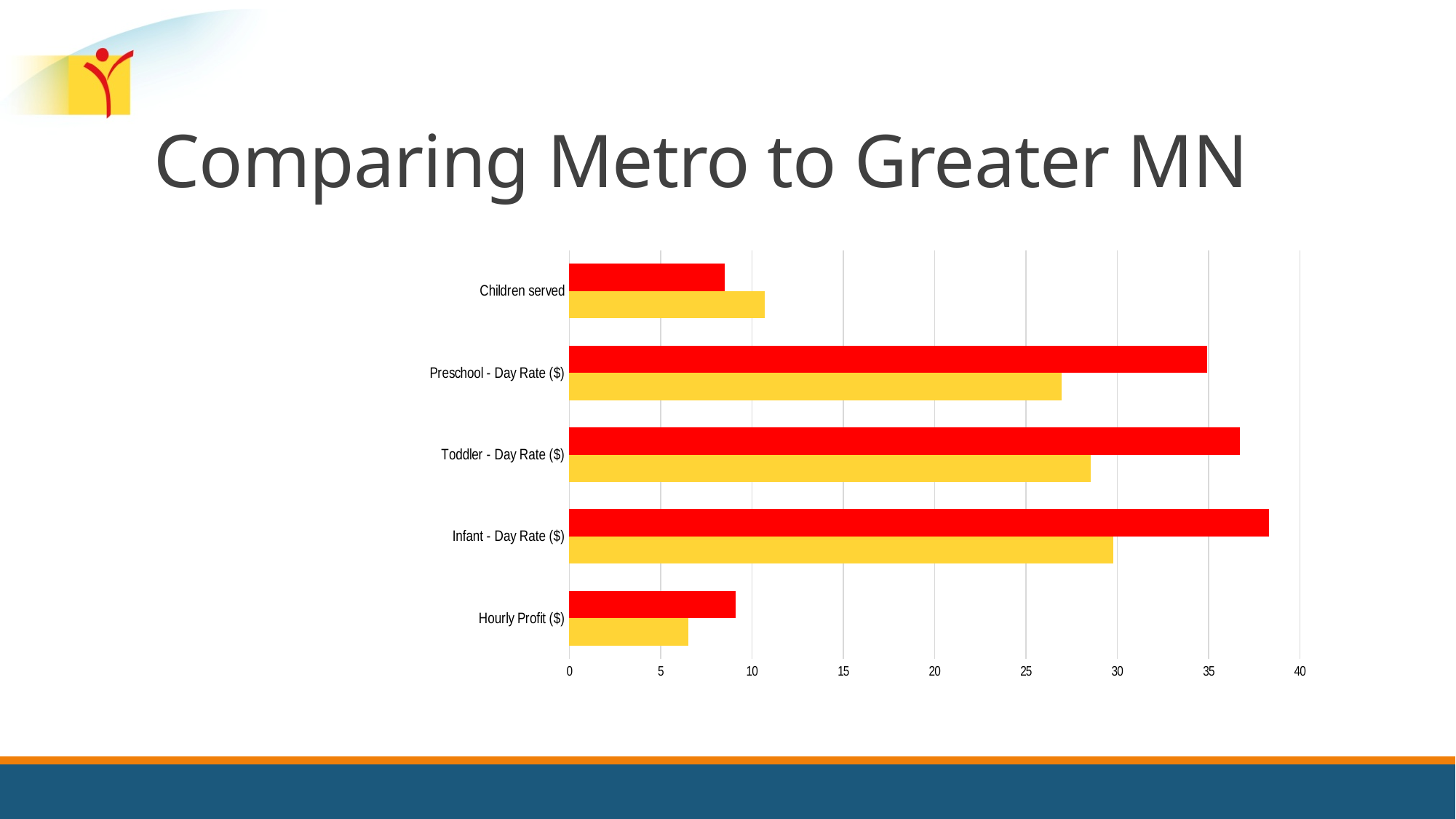
How many categories are shown on the chart's vertical axis? 5 Is the yellow bar for Preschool - Day Rate ($) greater or less than 30? less Is the yellow bar for Hourly Profit ($) greater or less than 5? greater What is the title of the slide containing the chart? Comparing Metro to Greater MN For Hourly Profit ($), which bar is longer, the red one or the yellow one? red For Children served, which bar is longer, the red one or the yellow one? yellow Is the red bar for Children served greater or less than 10? less How many bars are plotted for each category in the chart? 2 What two colours are used for the bars in the chart? red and yellow What kind of chart is shown on the slide? bar chart Which category has the longest red bar? Infant - Day Rate ($)